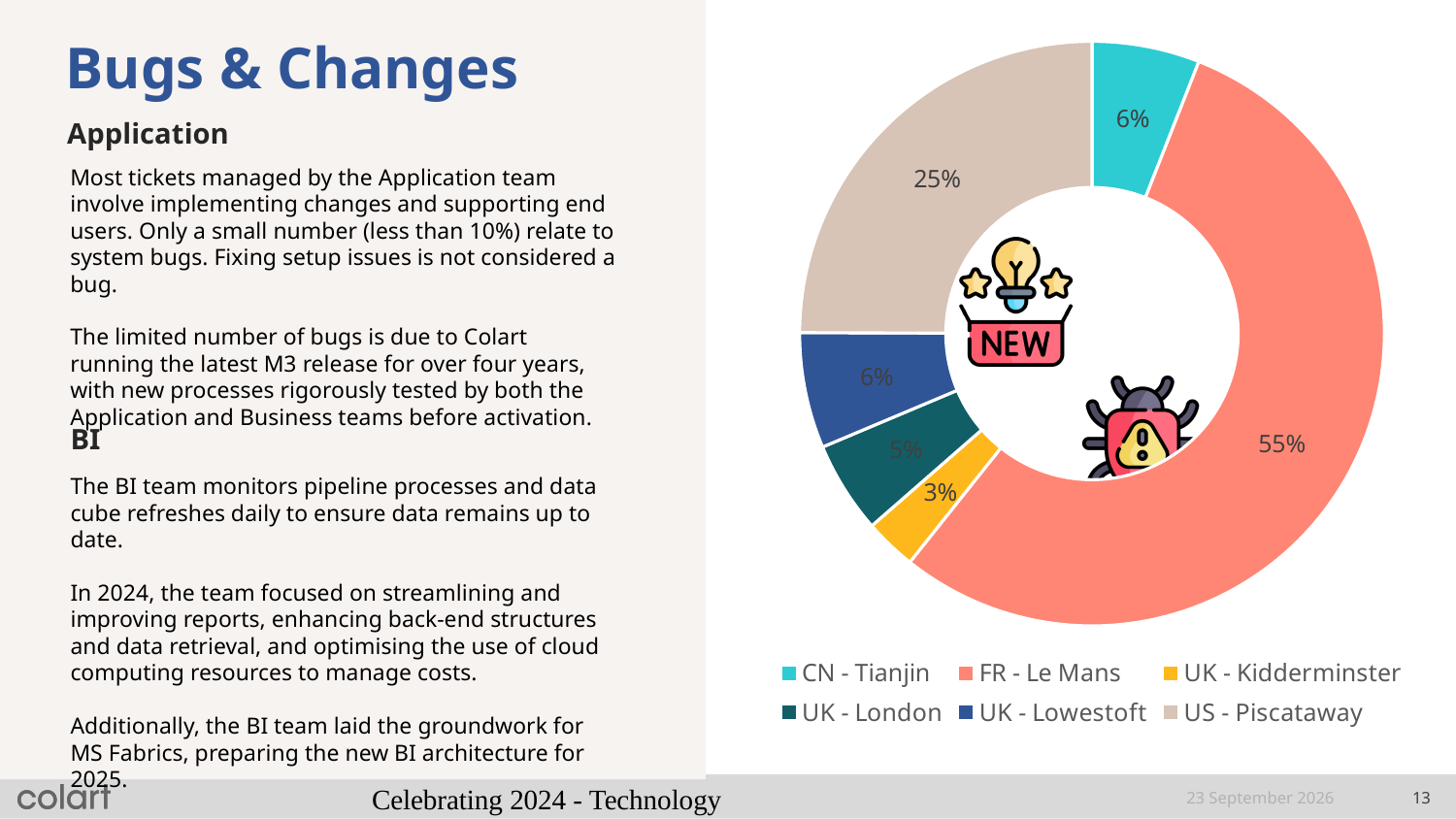
What is the difference in percentage points between FR - Le Mans and US - Piscataway? 30 How many slices does the pie chart have? 6 What percentage is shown for US - Piscataway? 25% What kind of chart is shown on the slide? Pie chart (doughnut) What percentage is shown for UK - Kidderminster? 3% Which legend entry is shown in cyan? CN - Tianjin Which category has the largest slice of the pie? FR - Le Mans What share of the pie does FR - Le Mans account for? 55% Which is larger, the share for UK - London or the share for UK - Kidderminster? UK - London Which category has the smallest slice of the pie? UK - Kidderminster How many entries does the legend list? 6 What percentage is shown for UK - London? 5%